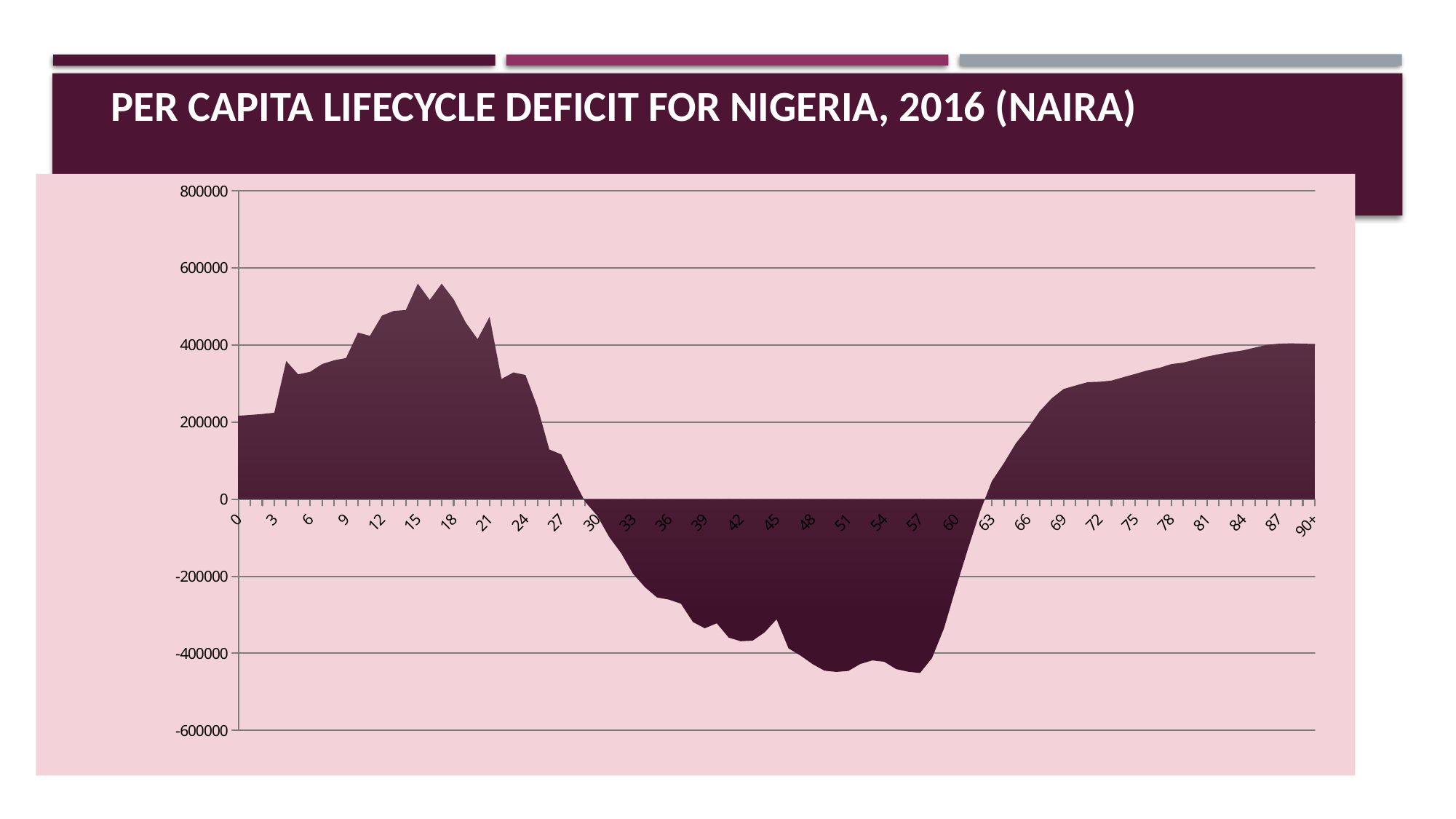
Is the value at age 18 greater or less than 400000? greater Which is larger, the value at age 18 or the value at age 69? age 18 Is the value at age 69 greater or less than 200000? greater Is the value at age 0 greater or less than 400000? less What is the title of the chart? PER CAPITA LIFECYCLE DEFICIT FOR NIGERIA, 2016 (NAIRA) Do the values rise or fall between age 30 and age 54? fall What kind of chart is shown on the slide? area chart Do the values rise or fall between age 63 and age 90+? rise What is the highest value shown on the vertical axis? 800000